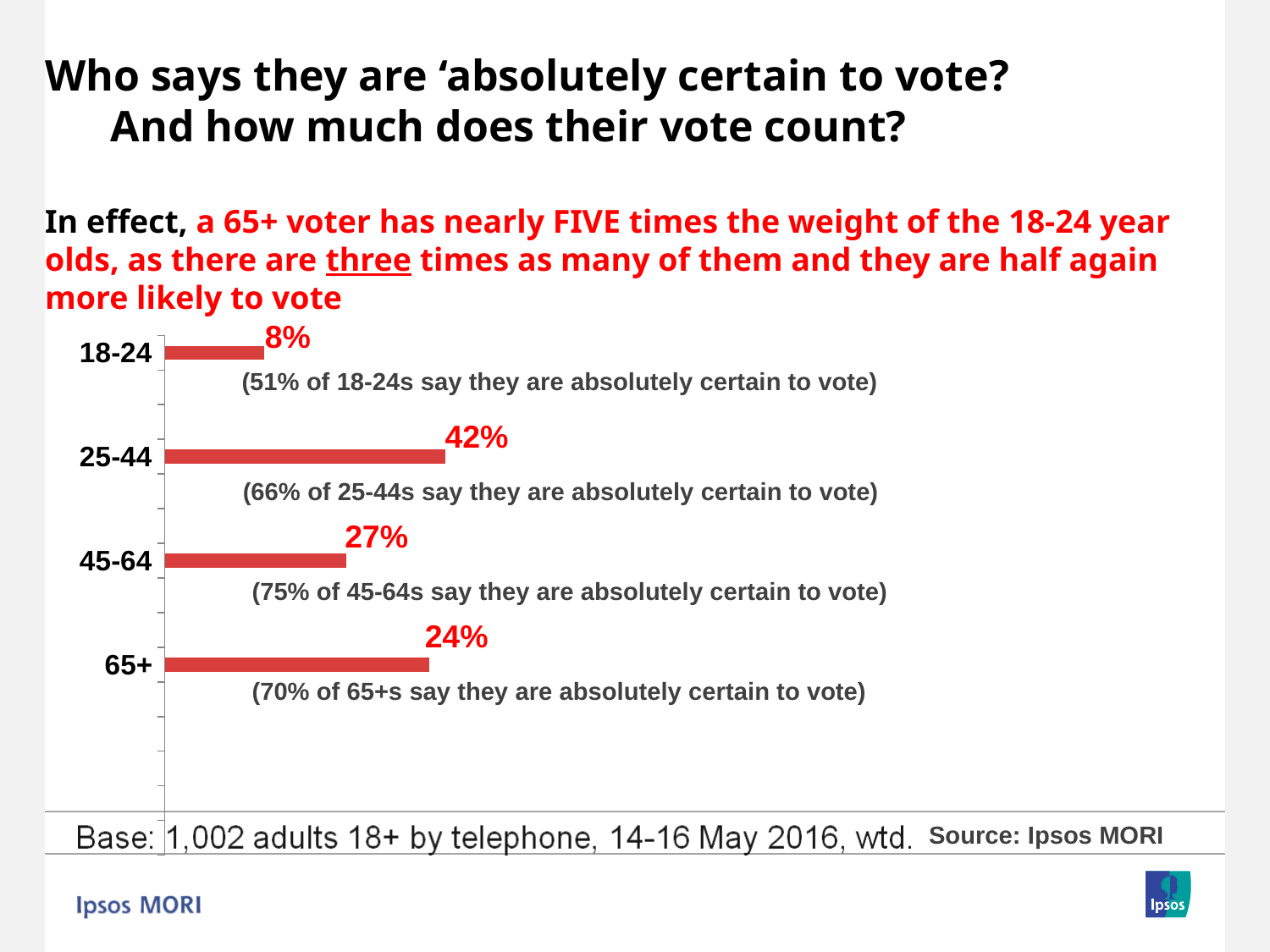
What is the difference between the values for 65+ and 18-24? 16 percentage points What value is shown for the 25-44 age group? 42% What colour are the bars in the chart? Red How many age groups are plotted in the chart? 4 Which age group has the highest value in the chart? 25-44 What is the difference between the values for 25-44 and 45-64? 15 percentage points What value is shown for the 65+ age group? 24% Which age group has the lowest value in the chart? 18-24 What value is shown for the 18-24 age group? 8% According to the annotation under the 45-64 bar, what percentage of 45-64s say they are absolutely certain to vote? 75% What kind of chart is shown on the slide? Bar chart